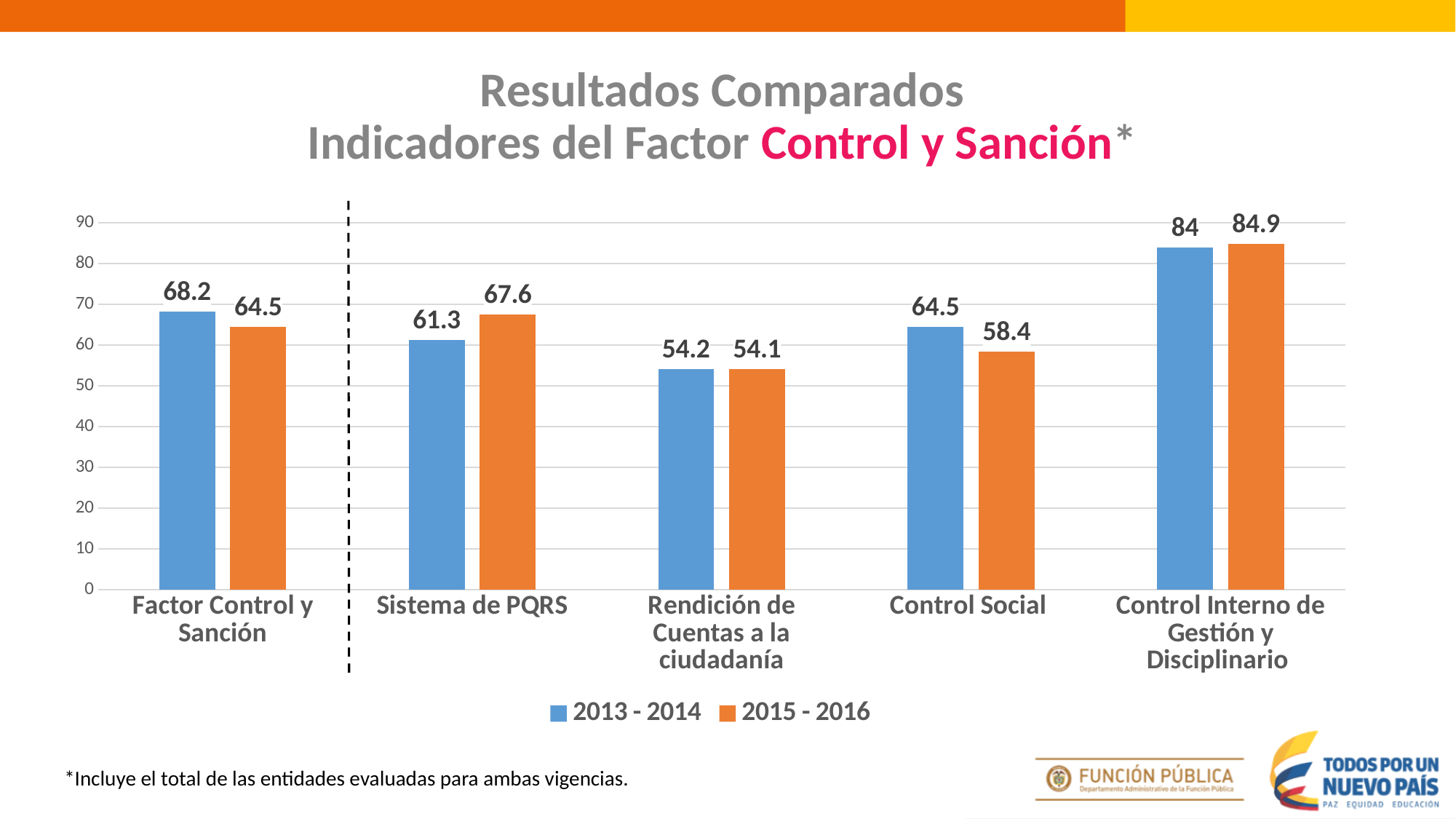
How many categories are shown on the x axis? 5 What is the difference between the 2015 - 2016 and 2013 - 2014 values for Sistema de PQRS? 6.3 How many series does the legend list? 2 What is the difference between the 2013 - 2014 and 2015 - 2016 values for Control Social? 6.1 What is the value for Control Social in the 2013 - 2014 series? 64.5 Which category has the highest value in the 2015 - 2016 series? Control Interno de Gestión y Disciplinario Which category has the lowest value in the 2013 - 2014 series? Rendición de Cuentas a la ciudadanía Which is larger for Factor Control y Sanción: the 2013 - 2014 value or the 2015 - 2016 value? 2013 - 2014 What is the value for Sistema de PQRS in the 2015 - 2016 series? 67.6 What kind of chart is shown on the slide? Bar chart What is the value for Rendición de Cuentas a la ciudadanía in the 2015 - 2016 series? 54.1 Is the 2013 - 2014 value for Control Interno de Gestión y Disciplinario greater or less than 80? greater